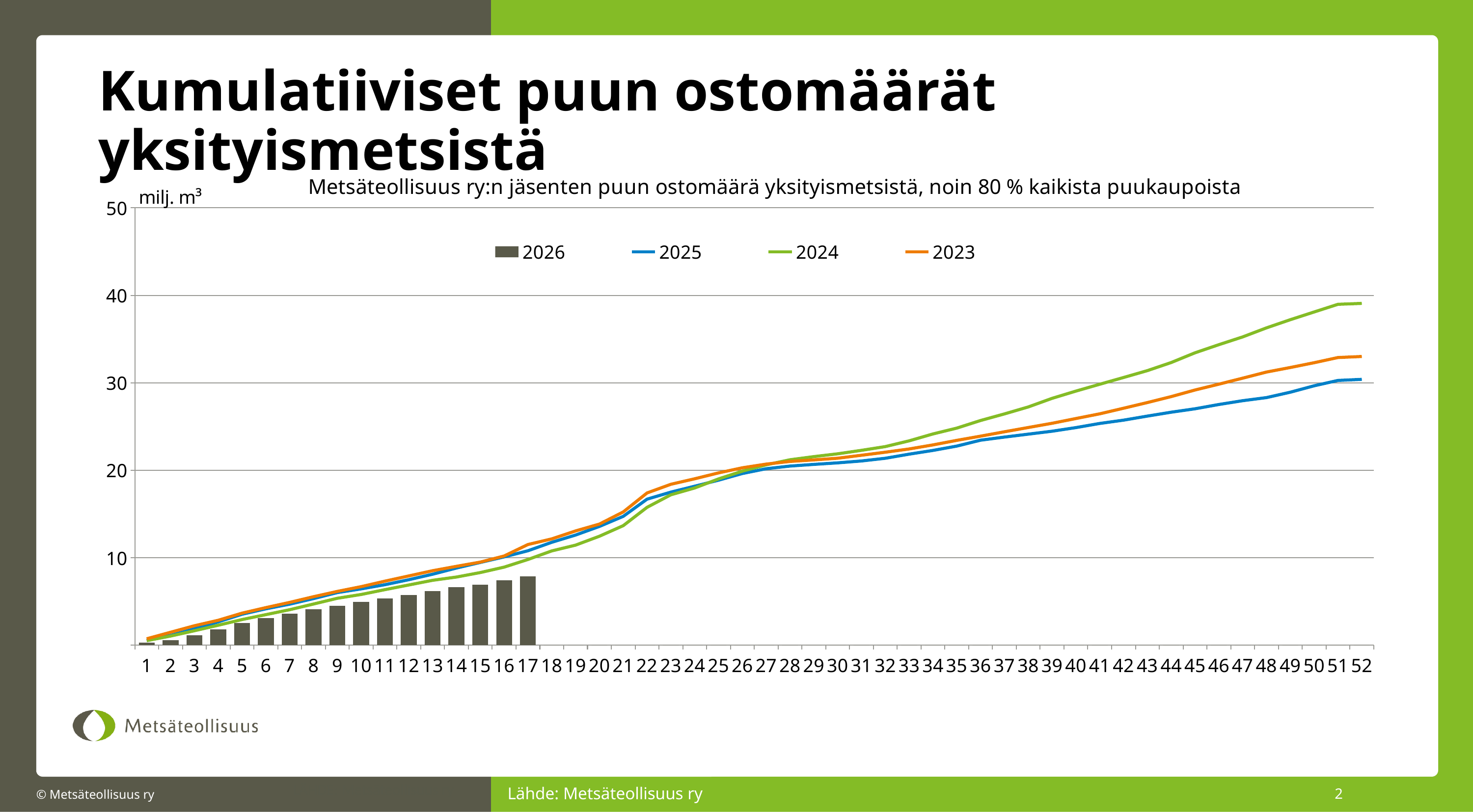
Which series has the lowest value at week 52? 2025 Up to which week are bars plotted for the 2026 series? 17 Is the value for 2026 at week 17 greater or less than 10? less Which series is shown as bars rather than a line? 2026 Is the value for 2024 at week 52 greater or less than 40? less Do the line series rise or fall as the week number increases? rise How many series does the legend list? 4 Which series has the highest value at week 52? 2024 What kind of chart is this? A combined bar and line chart How many weeks are labelled on the x axis? 52 At week 17, which is larger: the 2023 line or the 2026 bar? 2023 Is the value for 2024 at week 52 greater or less than 30? greater